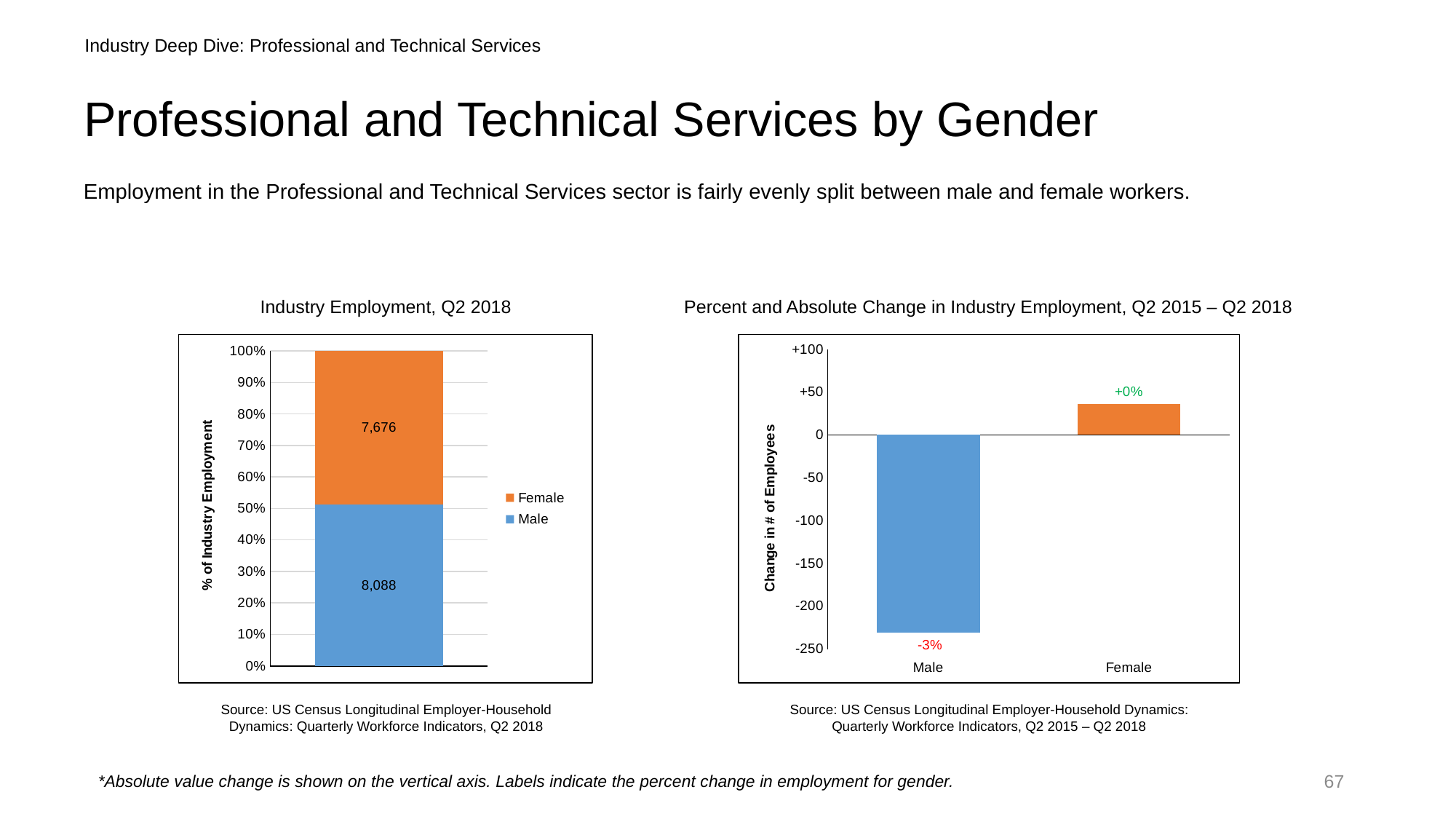
In the Industry Employment, Q2 2018 chart, which segment is larger, Male or Female? Male How many series does the legend of the Industry Employment, Q2 2018 chart list? 2 In the Industry Employment, Q2 2018 chart, what is the value shown for Female? 7,676 In the Industry Employment, Q2 2018 chart, what is the difference between the Male and Female values? 412 In the Industry Employment, Q2 2018 chart, what is the value shown for Male? 8,088 In the Percent and Absolute Change in Industry Employment chart, what percent change label is shown for Female? +0% In the Percent and Absolute Change in Industry Employment chart, what percent change label is shown for Male? -3% In the Percent and Absolute Change in Industry Employment chart, is the change in number of employees for Male greater or less than -200? less In the Percent and Absolute Change in Industry Employment chart, is the change in number of employees for Female greater or less than 0? greater What kind of chart is the Industry Employment, Q2 2018 chart? Stacked bar chart How many categories are shown on the x axis of the Percent and Absolute Change in Industry Employment chart? 2 In the Industry Employment, Q2 2018 chart, what is the total of the stacked bar? 15,764